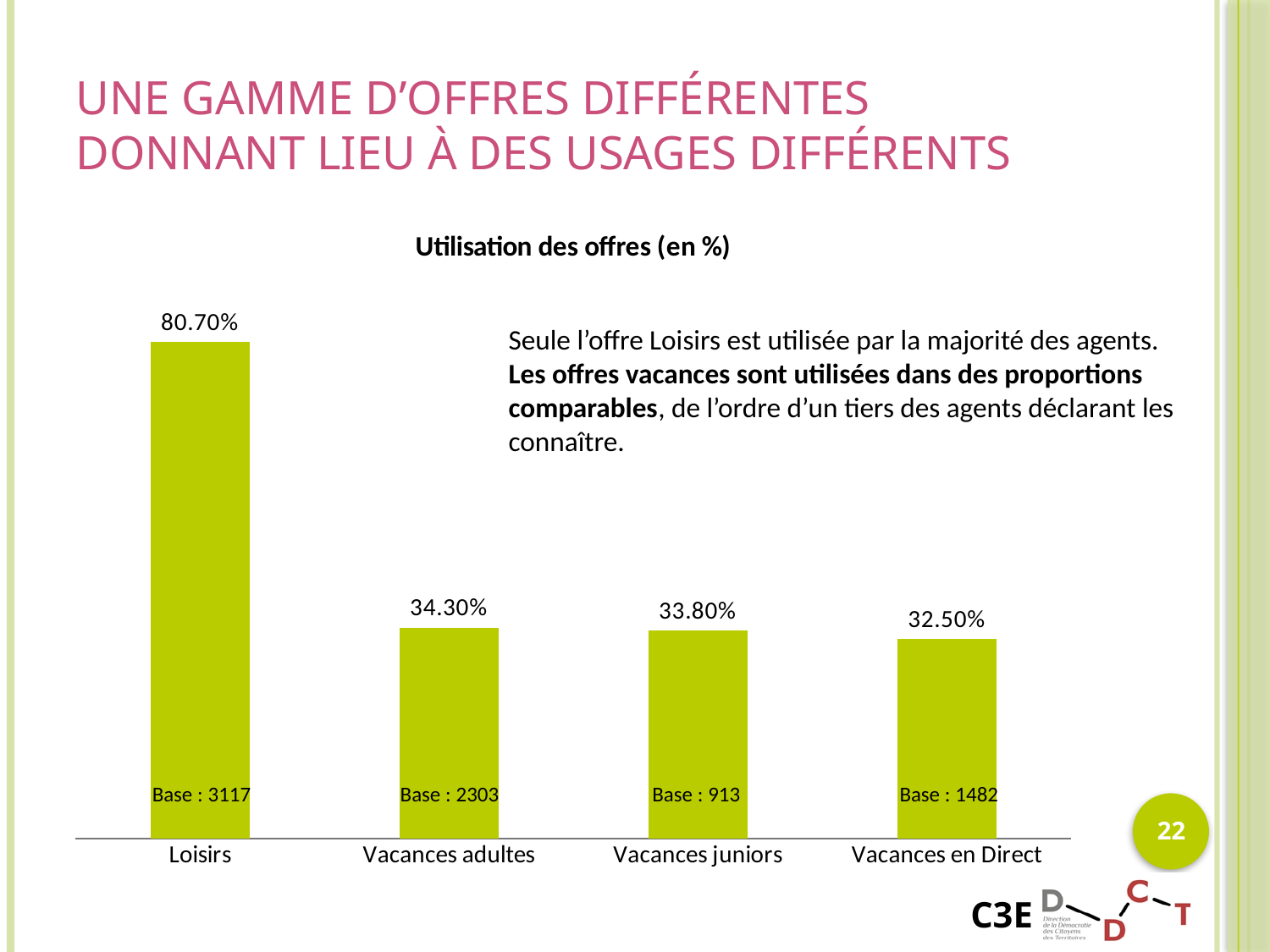
What is the value for Vacances adultes? 34.30% What is the value for Loisirs? 80.70% What is the value for Vacances en Direct? 32.50% What is the difference between the values for Vacances juniors and Vacances en Direct? 1.30% Which category has the lowest value? Vacances en Direct What is the difference between the values for Loisirs and Vacances adultes? 46.40% How many categories are shown in the chart? 4 What is the value for Vacances juniors? 33.80% Which is larger, the value for Loisirs or the value for Vacances juniors? Loisirs Which category has the highest value? Loisirs What is the title of the chart? Utilisation des offres (en %) What kind of chart is shown on the slide? Bar chart